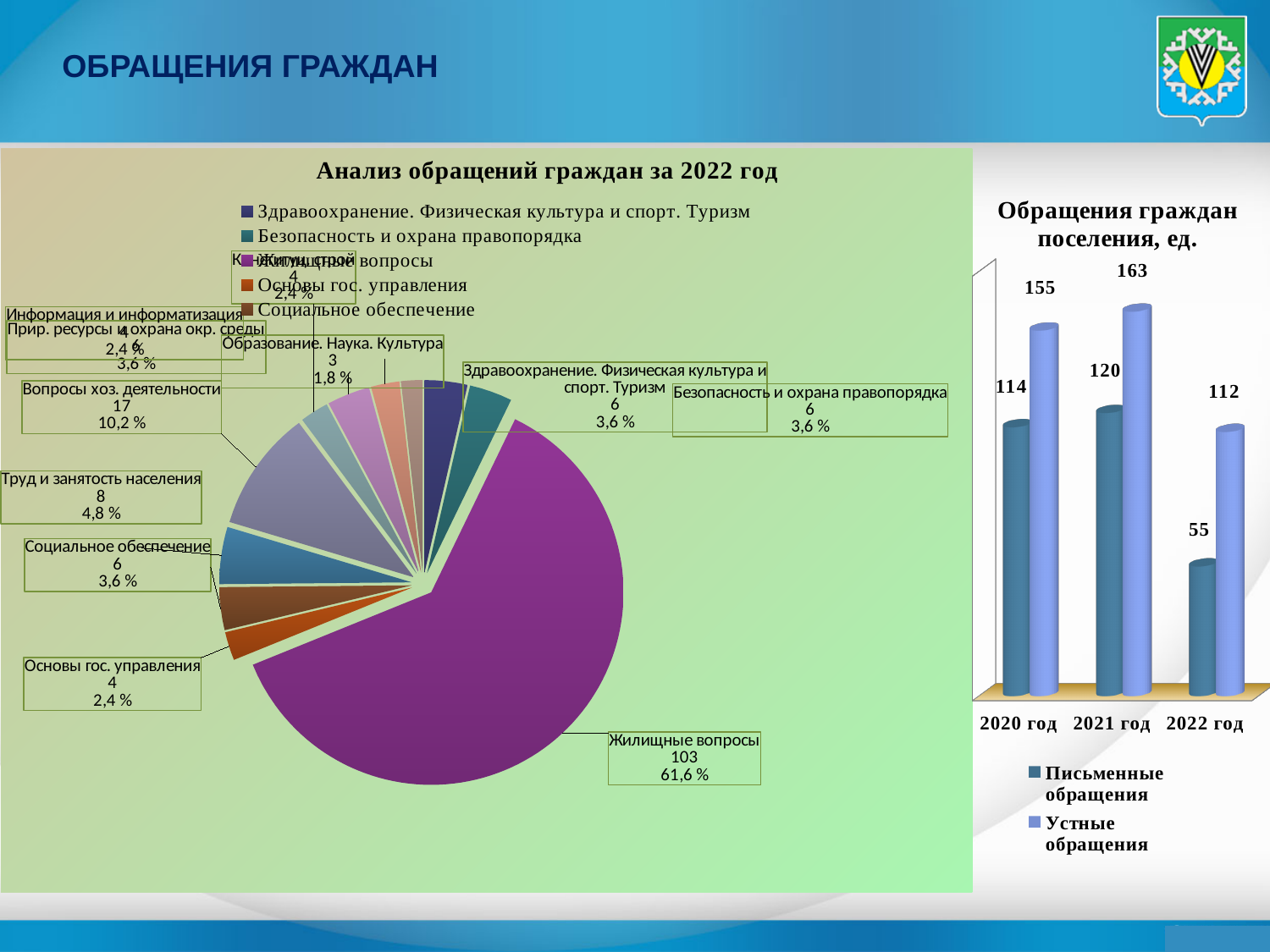
In the chart 'Обращения граждан поселения, ед.', which year has the highest value of Устные обращения? 2021 год In the pie chart 'Анализ обращений граждан за 2022 год', how many appeals are in the category Вопросы хоз. деятельности? 17 In the chart 'Обращения граждан поселения, ед.', which year has the lowest value of Письменные обращения? 2022 год In the pie chart 'Анализ обращений граждан за 2022 год', which is larger: Труд и занятость населения or Основы гос. управления? Труд и занятость населения In the pie chart 'Анализ обращений граждан за 2022 год', which category has the smallest slice? Образование. Наука. Культура In the chart 'Обращения граждан поселения, ед.', how many series does the legend list? 2 In the chart 'Обращения граждан поселения, ед.', what is the difference between Устные обращения and Письменные обращения in 2020 год? 41 What kind of chart is 'Анализ обращений граждан за 2022 год'? pie chart In the chart 'Обращения граждан поселения, ед.', what is the value of Письменные обращения for 2021 год? 120 In the chart 'Обращения граждан поселения, ед.', what is the value of Устные обращения for 2022 год? 112 In the pie chart 'Анализ обращений граждан за 2022 год', what share does Жилищные вопросы have? 61,6 % What kind of chart is 'Обращения граждан поселения, ед.'? bar chart